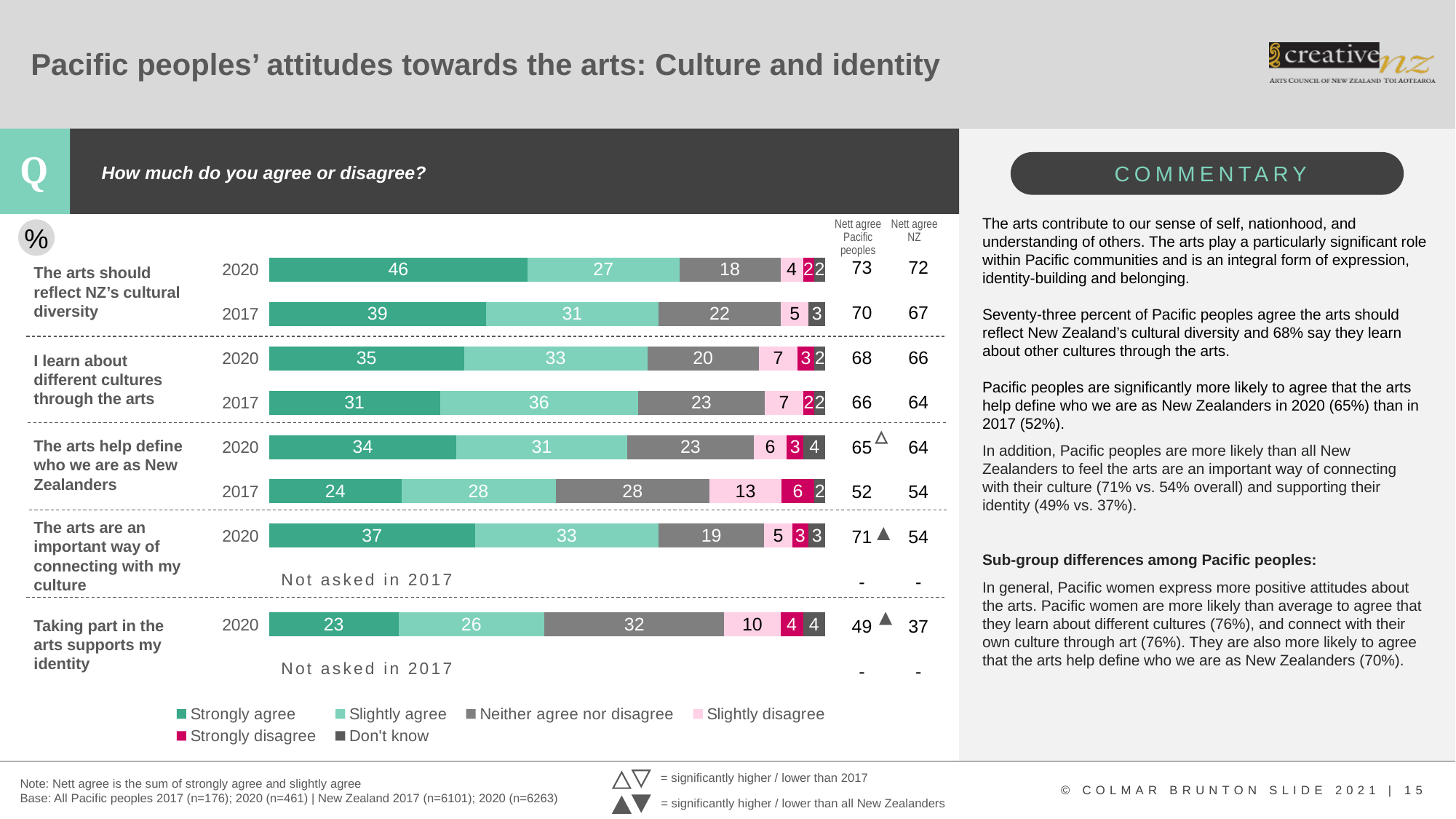
Which statement has the highest 'Strongly agree' percentage among the 2020 bars? The arts should reflect NZ's cultural diversity Which statement has the lowest Nett agree figure for Pacific peoples in 2020? Taking part in the arts supports my identity By how many percentage points did the Nett agree figure for Pacific peoples for 'The arts help define who we are as New Zealanders' change from 2017 to 2020? 13 Which is larger for 'The arts are an important way of connecting with my culture' in 2020: the Nett agree for Pacific peoples or the Nett agree for NZ? Nett agree Pacific peoples How many response categories does the legend list? 6 What percentage of Pacific peoples strongly agreed in 2020 that the arts should reflect NZ's cultural diversity? 46 What type of chart is used on this slide? Stacked bar chart What is the Nett agree figure for Pacific peoples in 2020 for 'The arts are an important way of connecting with my culture'? 71 What is the Nett agree NZ figure for 'Taking part in the arts supports my identity' in 2020? 37 Which statements were not asked in 2017? The arts are an important way of connecting with my culture; Taking part in the arts supports my identity What percentage of Pacific peoples answered 'Neither agree nor disagree' in 2020 for 'Taking part in the arts supports my identity'? 32 How many statements are shown in the chart? 5